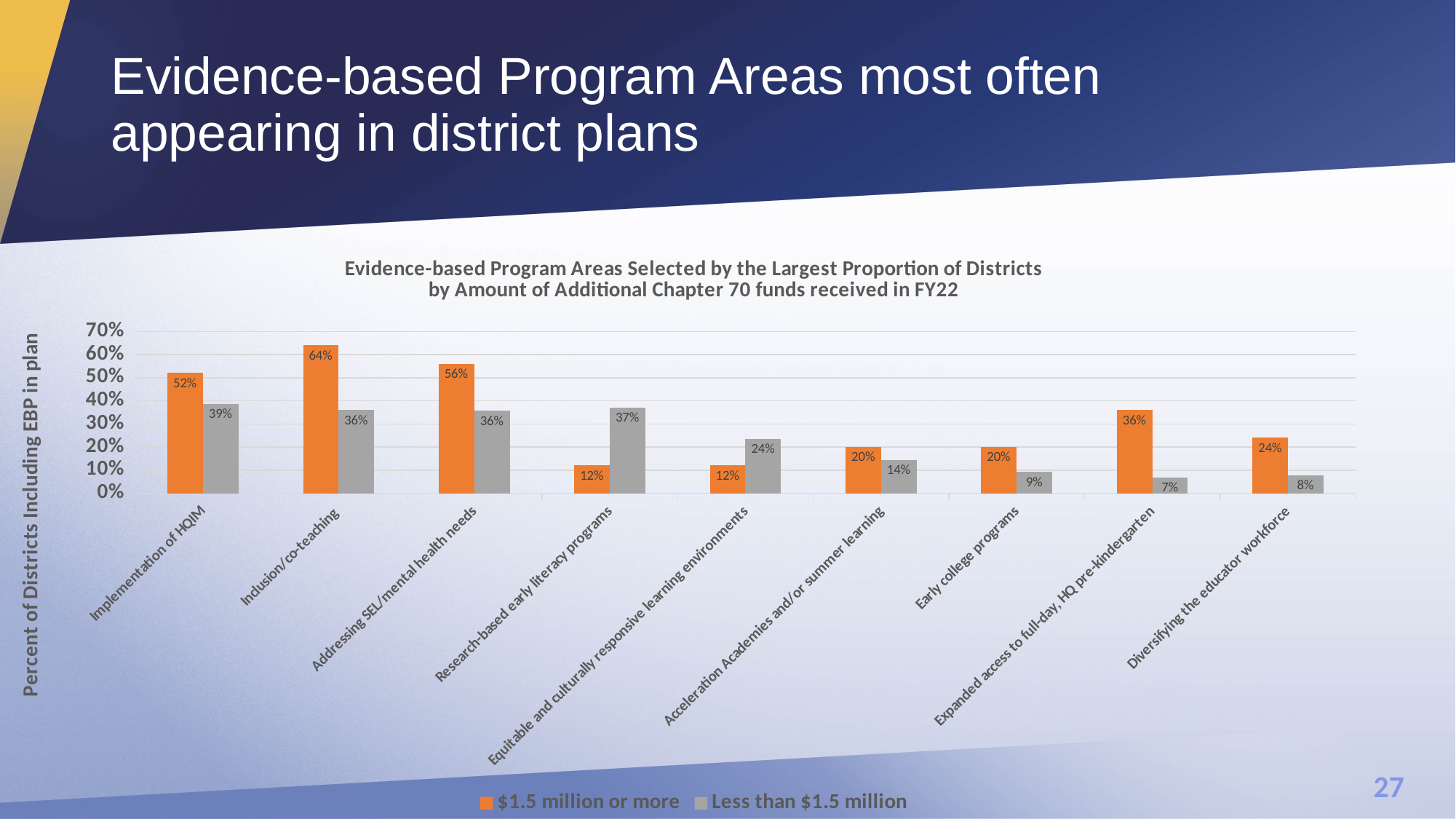
What is the value for Expanded access to full-day, HQ pre-kindergarten in the Less than $1.5 million series? 7% Which category has the lowest value in the Less than $1.5 million series? Expanded access to full-day, HQ pre-kindergarten For Equitable and culturally responsive learning environments, which series has the larger value? Less than $1.5 million How many series does the legend list? 2 Is the value for Implementation of HQIM in the $1.5 million or more series greater or less than 40%? greater What type of chart is shown on the slide? bar chart What is the value for Research-based early literacy programs in the Less than $1.5 million series? 37% Which category has the highest value in the $1.5 million or more series? Inclusion/co-teaching How many program area categories are shown on the x axis? 9 What is the value for Inclusion/co-teaching in the $1.5 million or more series? 64% What is the label of the y axis? Percent of Districts Including EBP in plan What is the difference between the $1.5 million or more and Less than $1.5 million values for Addressing SEL/mental health needs? 20%